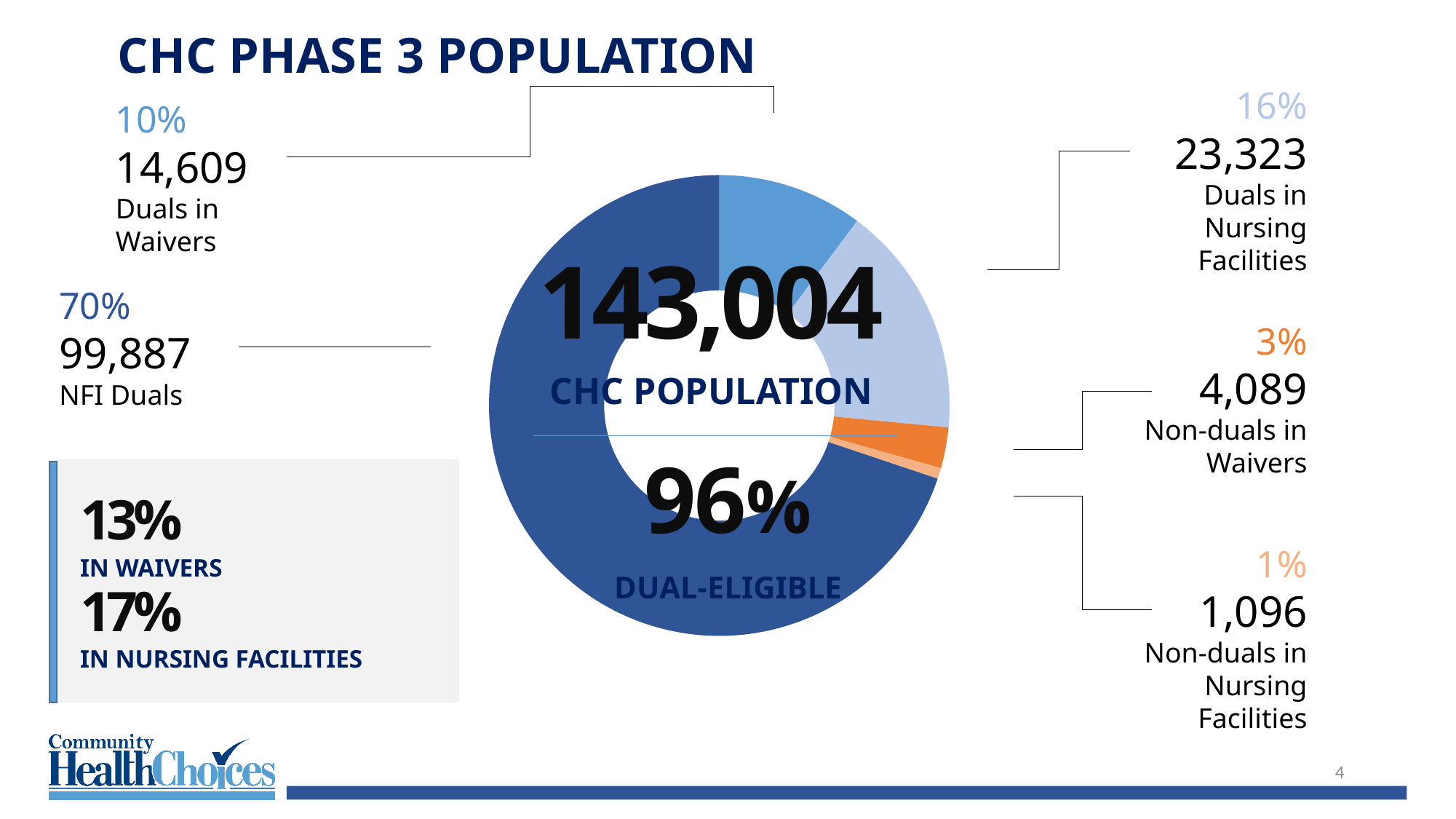
What is the total CHC population shown in the centre of the chart? 143,004 What percentage of the population is Non-duals in Waivers? 3% Which segment is the smallest? Non-duals in Nursing Facilities Which segment is the largest? NFI Duals What percentage of the CHC population is dual-eligible according to the chart centre? 96% How many Duals in Nursing Facilities are shown? 23,323 What kind of chart is shown on the slide? Donut (pie) chart What share of the CHC population is NFI Duals? 70% Which is larger, Duals in Waivers or Duals in Nursing Facilities? Duals in Nursing Facilities How many segments does the donut chart have? 5 How many NFI Duals are shown? 99,887 What is the difference between the number of Duals in Nursing Facilities and Duals in Waivers? 8,714